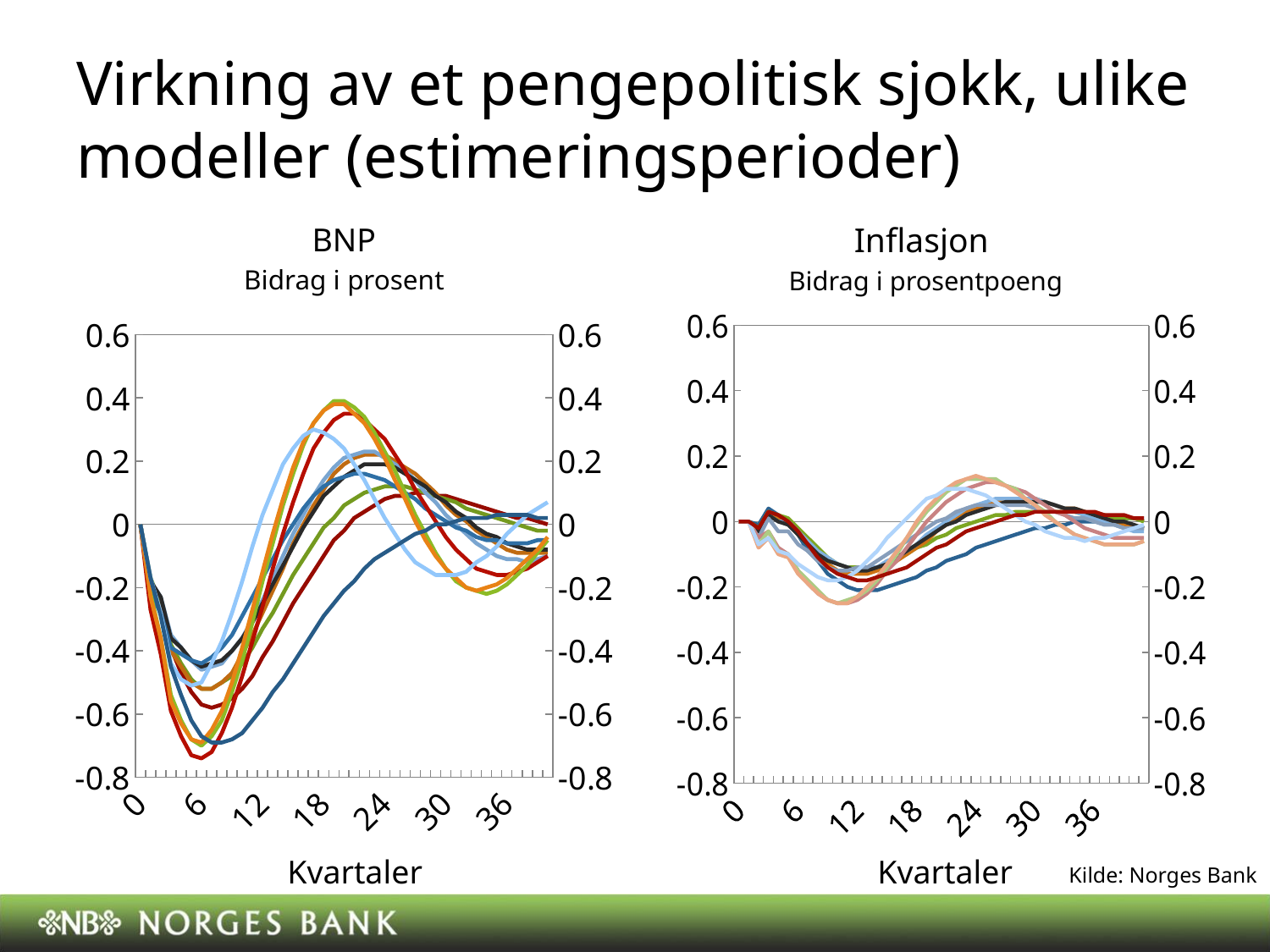
How many charts are shown on the slide? 2 What is the subtitle under the Inflasjon chart title? Bidrag i prosentpoeng In the BNP chart, do the lines initially rise or fall from quarter 0? fall In the BNP chart, is the highest value reached by any line greater or less than 0.6? less In the BNP chart, is the highest value reached by any line greater or less than 0.2? greater In the BNP chart, is the lowest value reached by any line greater or less than -0.6? less What is the x-axis label on the BNP chart? Kvartaler What kind of chart is the BNP chart on the left? Line chart In the Inflasjon chart, do the lines rise or fall between quarter 6 and quarter 12? fall What kind of chart is the Inflasjon chart on the right? Line chart